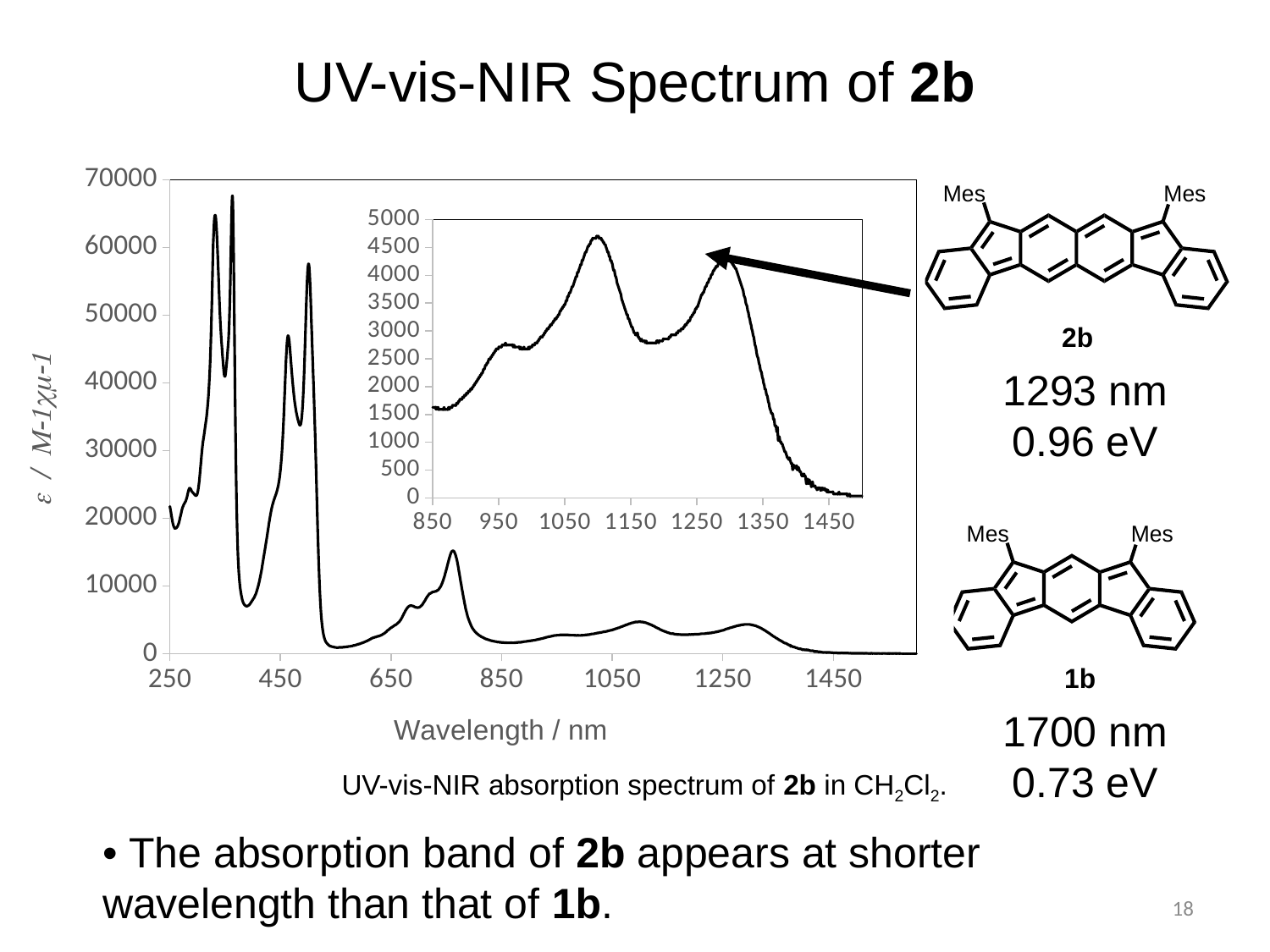
In the main chart, is the tallest peak (near 350 nm) greater or less than 60000? greater In the main chart, does the curve rise or fall between 1300 nm and 1450 nm? fall In the main chart, is the value at 1450 nm greater or less than 10000? less What kind of chart is the main chart on the slide? line chart In the main chart, what is the highest value shown on the y axis? 70000 In the inset chart, is the highest peak (near 1100 nm) greater or less than 4000? greater In the main chart, what is the label of the x axis? Wavelength / nm In the inset chart, does the curve rise or fall between 1300 nm and 1450 nm? fall